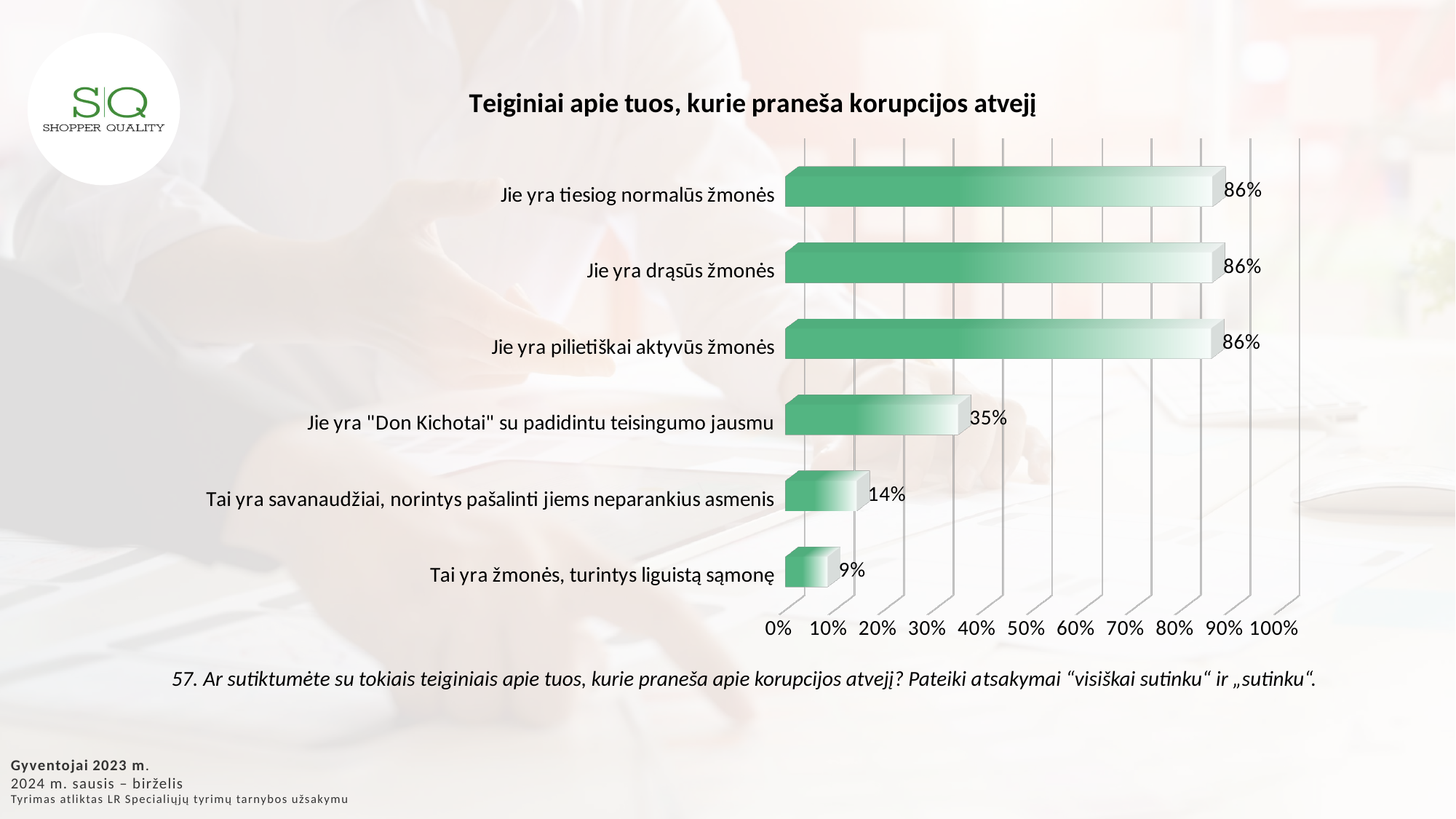
What is the difference between the values for "Jie yra pilietiškai aktyvūs žmonės" and "Jie yra "Don Kichotai" su padidintu teisingumo jausmu"? 51% What is the value for "Jie yra "Don Kichotai" su padidintu teisingumo jausmu"? 35% Which is larger: the value for "Jie yra "Don Kichotai" su padidintu teisingumo jausmu" or the value for "Tai yra savanaudžiai, norintys pašalinti jiems neparankius asmenis"? Jie yra "Don Kichotai" su padidintu teisingumo jausmu What is the value for "Tai yra savanaudžiai, norintys pašalinti jiems neparankius asmenis"? 14% What is the difference between the values for "Tai yra savanaudžiai, norintys pašalinti jiems neparankius asmenis" and "Tai yra žmonės, turintys liguistą sąmonę"? 5% How many categories have a value of 86%? 3 What kind of chart is shown on the slide? bar chart Which category has the lowest value? Tai yra žmonės, turintys liguistą sąmonę How many categories are shown in the chart? 6 What is the value for "Jie yra drąsūs žmonės"? 86% Is the value for "Jie yra tiesiog normalūs žmonės" greater or less than 80%? greater What is the title of the chart? Teiginiai apie tuos, kurie praneša korupcijos atvejį